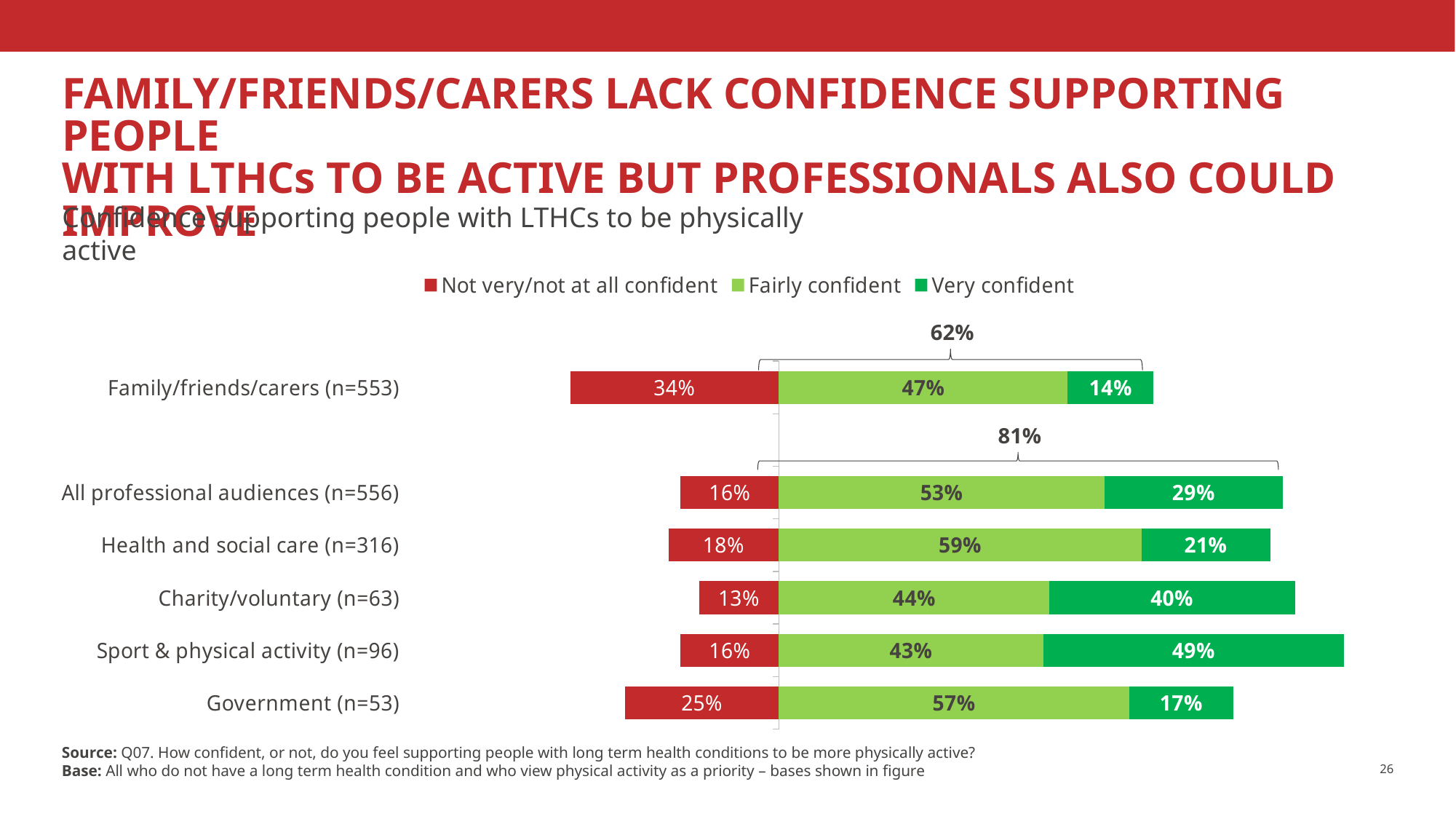
What is the Fairly confident value for Health and social care (n=316)? 59% What percentage of Family/friends/carers (n=553) are not very/not at all confident? 34% What percentage of Sport & physical activity (n=96) respondents are very confident? 49% What is the Very confident value for Government (n=53)? 17% What type of chart is shown on the slide? Stacked bar chart Which is larger: the Fairly confident value for Government (n=53) or for All professional audiences (n=556)? Government (n=53) Which category has the lowest Not very/not at all confident percentage? Charity/voluntary (n=63) What combined percentage is shown above the bracket for All professional audiences (n=556)? 81% What is the difference between the Very confident values for Sport & physical activity (n=96) and Family/friends/carers (n=553)? 35% How many series does the legend list? 3 Which category has the highest Very confident percentage? Sport & physical activity (n=96) How many categories are shown in the chart? 6